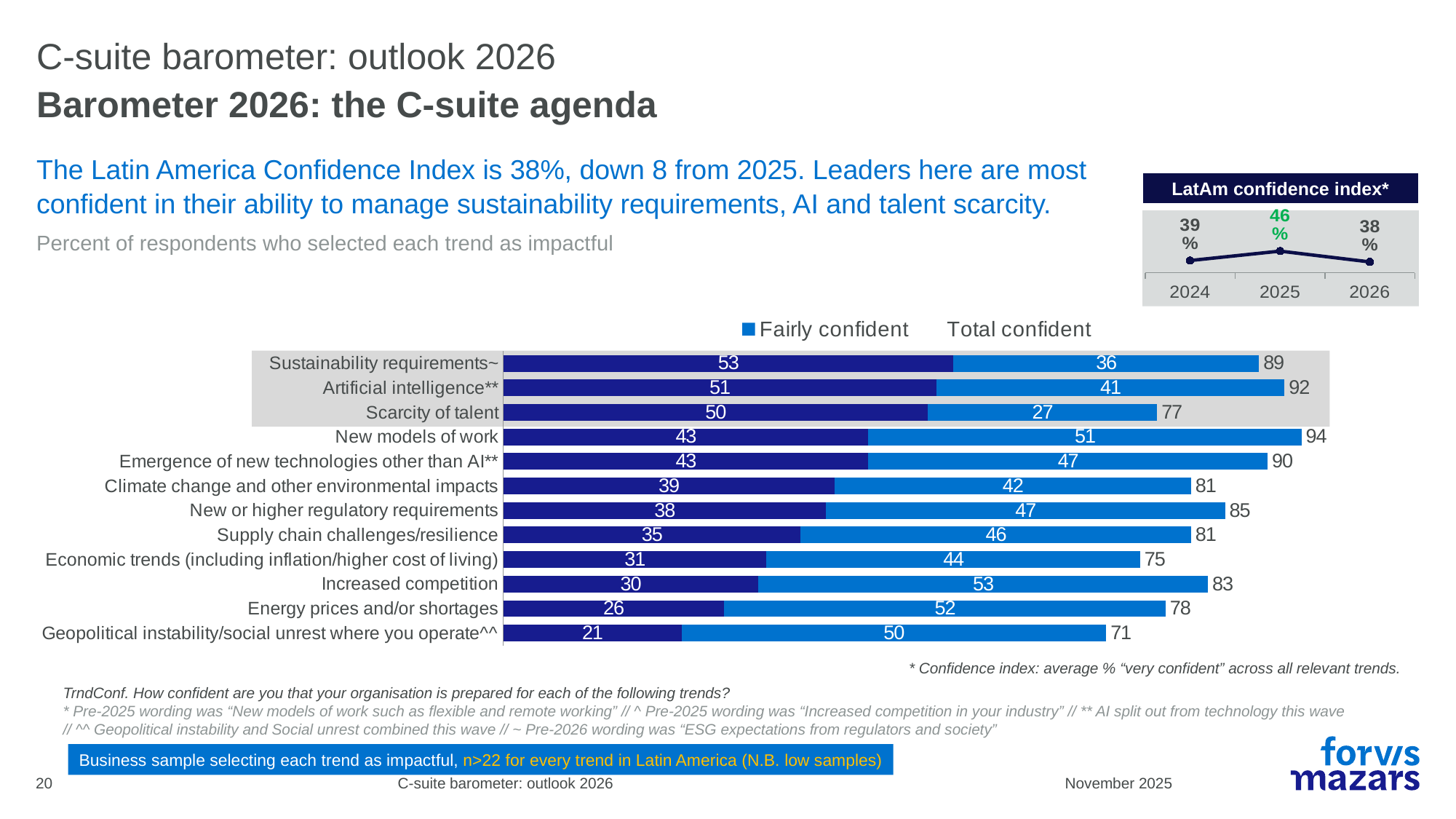
In the LatAm confidence index chart, which year has the lowest value? 2026 In the main stacked bar chart, which trend has the highest total value? New models of work In the main stacked bar chart, what is the Fairly confident value for Increased competition? 53 In the LatAm confidence index chart, what is the difference between the 2025 and 2026 values? 8 In the main stacked bar chart, what is the total value shown for New models of work? 94 What kind of chart is the LatAm confidence index chart? Line chart In the LatAm confidence index chart, what is the value for 2025? 46% What kind of chart is the main chart showing the trends? Stacked bar chart In the main stacked bar chart, which has the larger total value: Energy prices and/or shortages or Economic trends (including inflation/higher cost of living)? Energy prices and/or shortages In the main stacked bar chart, which trend has the lowest total value? Geopolitical instability/social unrest where you operate^^ In the main stacked bar chart, how many trends are listed? 12 In the main stacked bar chart, what is the difference between the total values for Artificial intelligence** and Scarcity of talent? 15